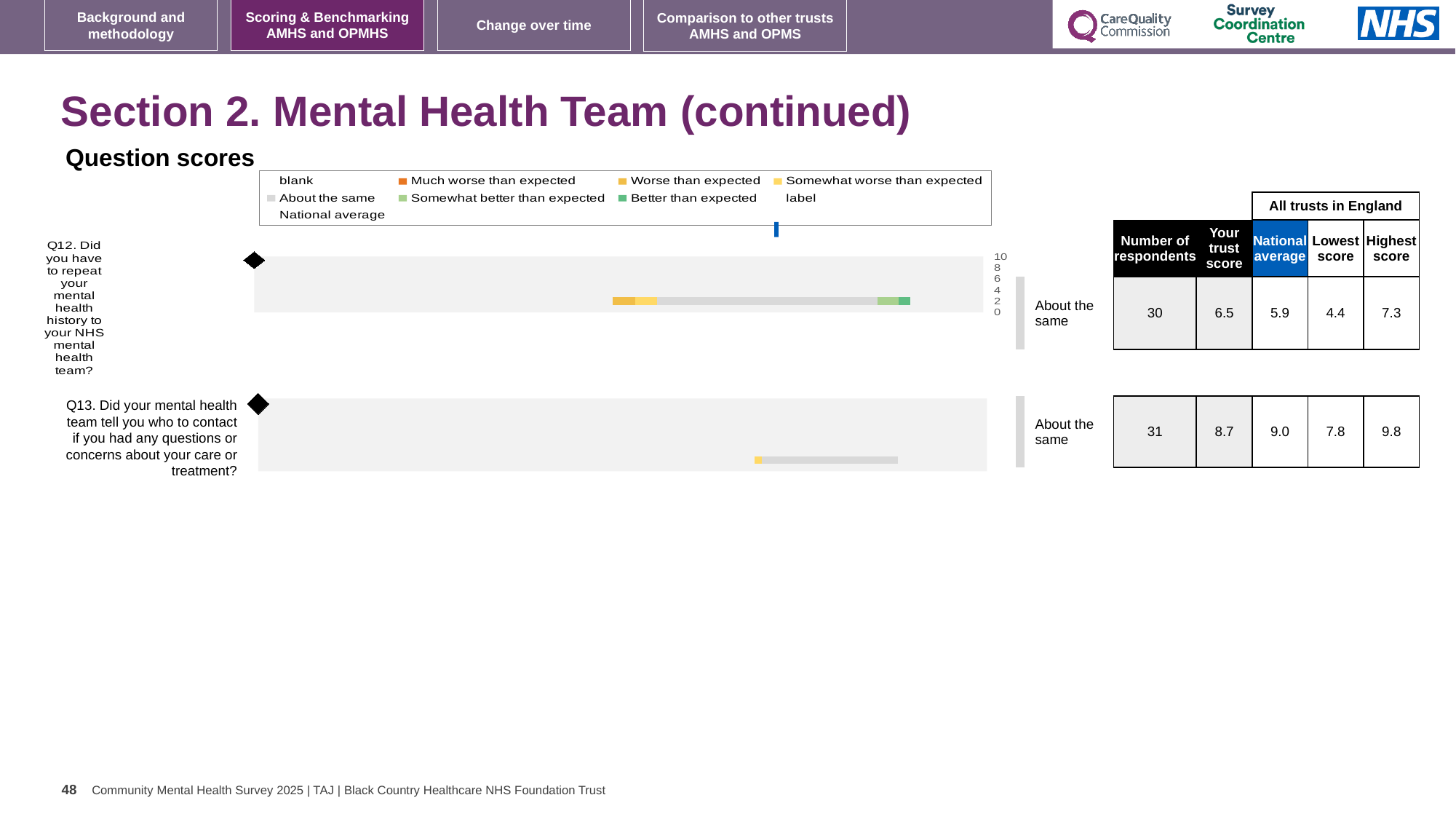
What is the difference between the highest and lowest scores for Q13? 2.0 Which is larger for Q12, the trust score or the national average? trust score What kind of chart is used to show the question scores for Q12 and Q13? bar chart What is the trust score for Q13 (told who to contact with questions or concerns)? 8.7 What is the highest score among all trusts in England for Q12? 7.3 What is the lowest score among all trusts in England for Q13? 7.8 Which is larger for Q13, the trust score or the national average? national average How many respondents answered Q13? 31 What benchmark category is shown for Q12? About the same What is the trust score for Q12 (repeating mental health history)? 6.5 What is the national average for Q12? 5.9 How many questions are plotted on the slide? 2